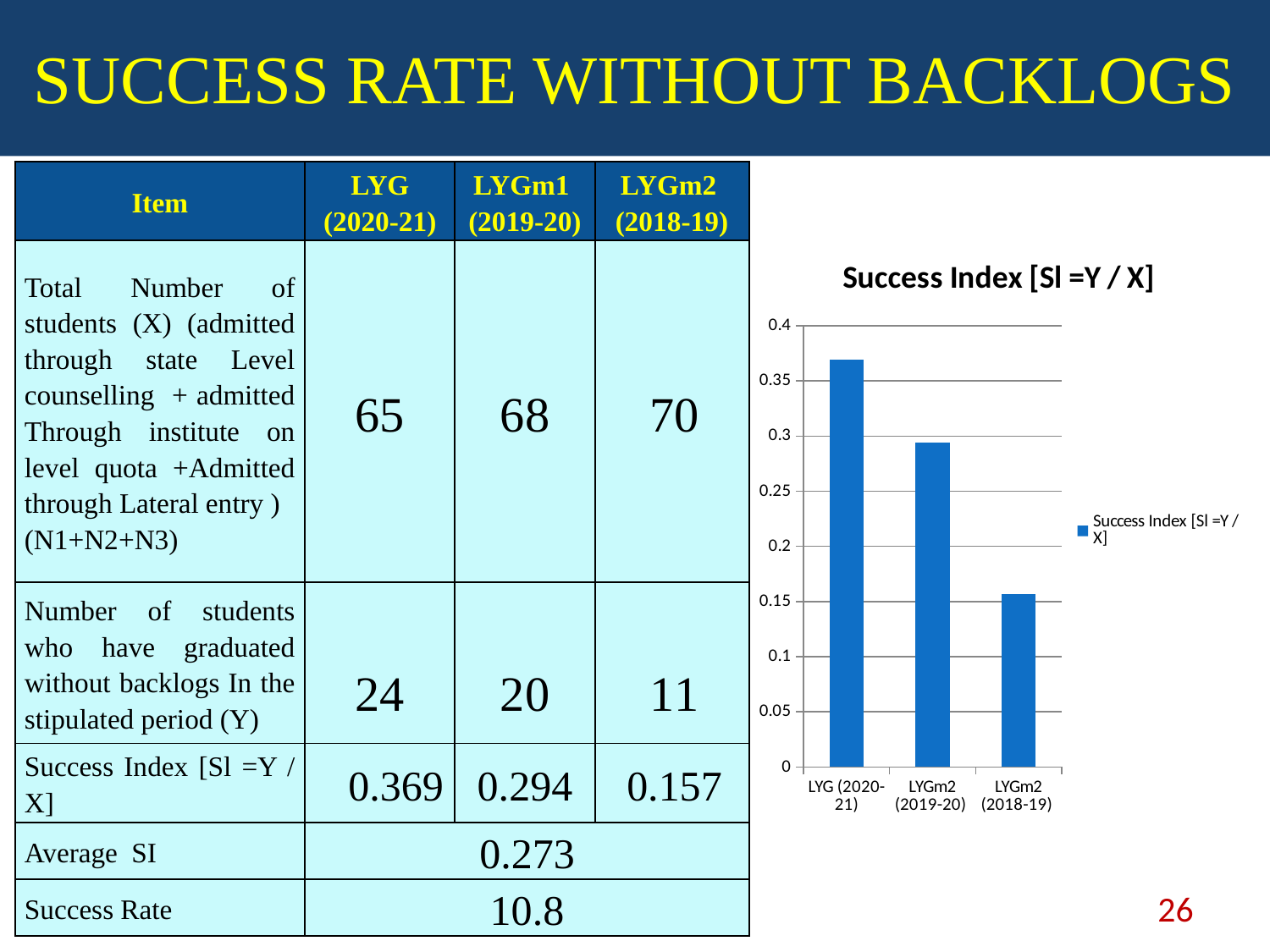
Is the Success Index for the 2018-19 bar greater or less than 0.2? less What is the Success Index value for LYG (2020-21) as printed in the table on the slide? 0.369 How many bars does the chart have? 3 Which category has the highest Success Index in the chart? LYG (2020-21) Is the Success Index for the 2019-20 bar greater or less than 0.3? less Which is larger, the Success Index for 2020-21 or for 2018-19? 2020-21 What is the title of the chart? Success Index [Sl =Y / X] Do the Success Index values rise or fall from left to right across the chart? fall Which category has the lowest Success Index in the chart? LYGm2 (2018-19) How many series does the chart legend list? 1 Is the Success Index for LYG (2020-21) greater or less than 0.35? greater What kind of chart is shown on the slide? bar chart